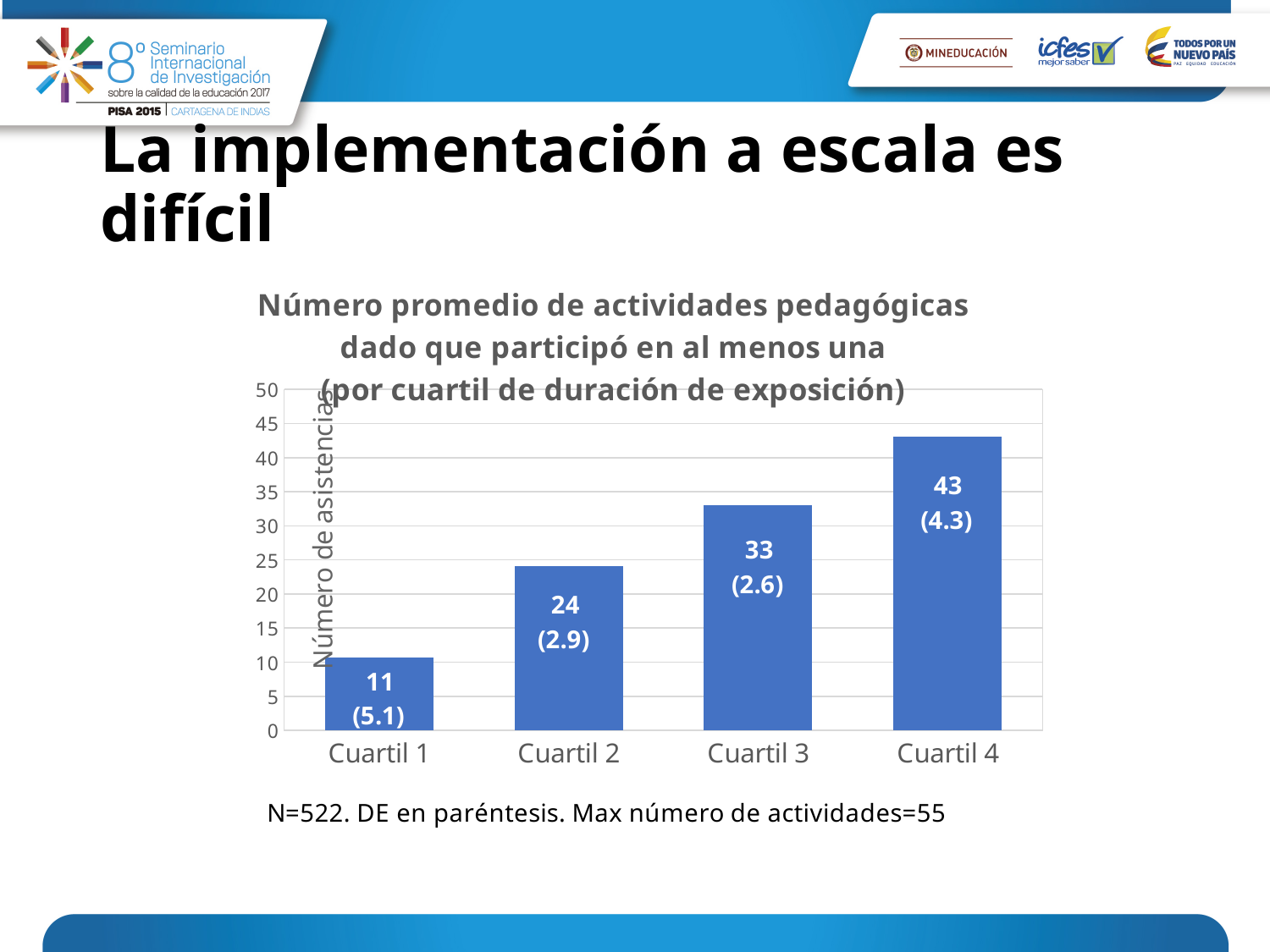
What is the standard deviation shown in parentheses for Cuartil 2? 2.9 What is the value for Cuartil 3? 33 Which cuartil has the lowest value? Cuartil 1 What kind of chart is shown on the slide? bar chart Do the values rise or fall from Cuartil 1 to Cuartil 4? rise Which is larger, the value for Cuartil 2 or Cuartil 3? Cuartil 3 Which cuartil has the highest value? Cuartil 4 How many cuartiles are shown on the x axis? 4 What is the label of the y axis? Número de asistencias What is the value for Cuartil 1? 11 What is the difference between the values for Cuartil 4 and Cuartil 2? 19 Is the value for Cuartil 4 greater or less than 40? greater